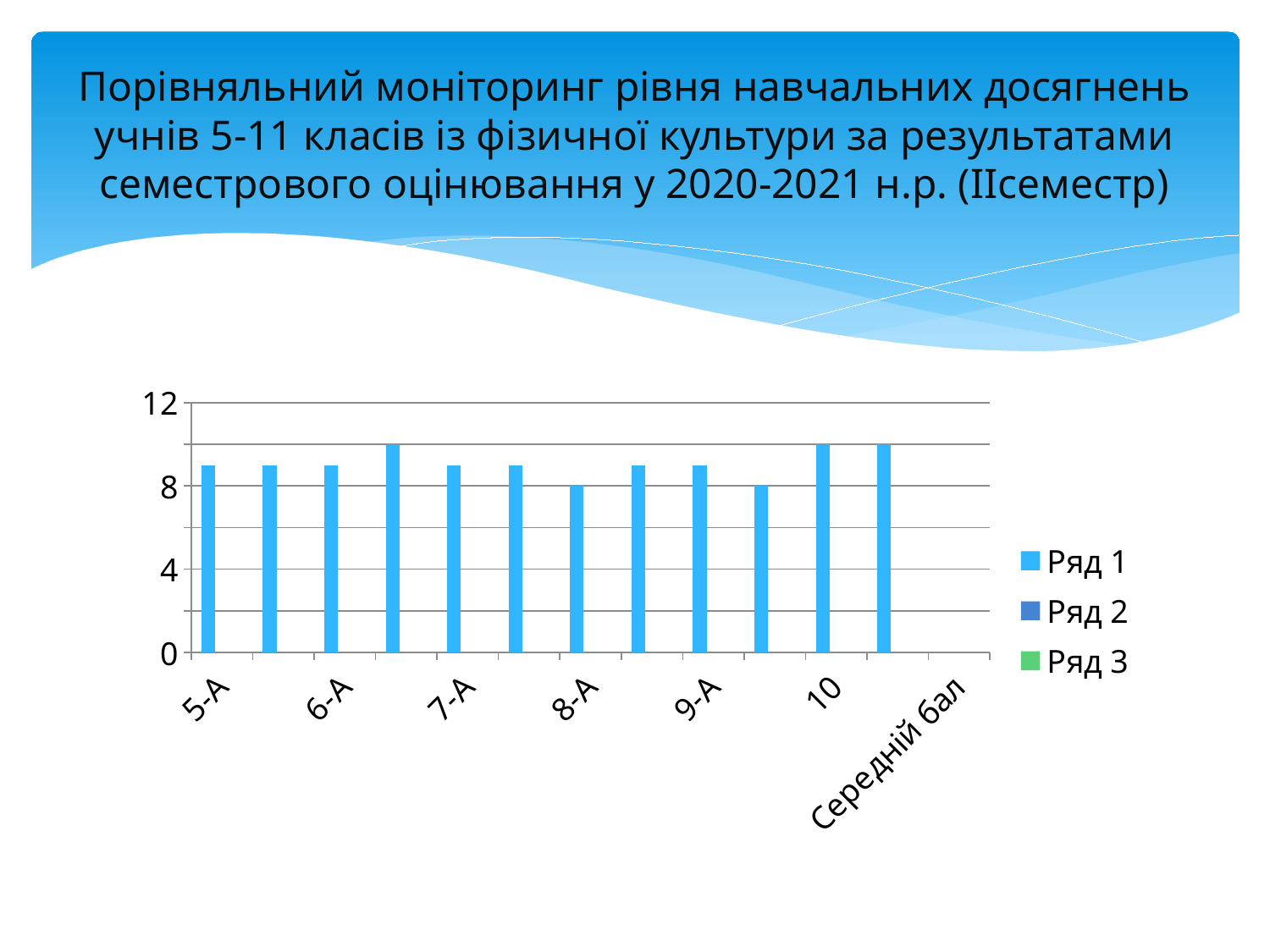
Is the value for 8-А greater or less than 4? greater Which has the larger value, 8-А or 10? 10 What is the value for 8-А? 8 What kind of chart is shown on the slide? bar chart Which has the larger value, 5-А or 8-А? 5-А How many series does the legend list? 3 Is the value for 9-А greater or less than 12? less Which has the larger value, 6-А or 8-А? 6-А Is the value for 5-А greater or less than 8? greater What is the first entry in the legend? Ряд 1 What colour are the plotted bars? light blue